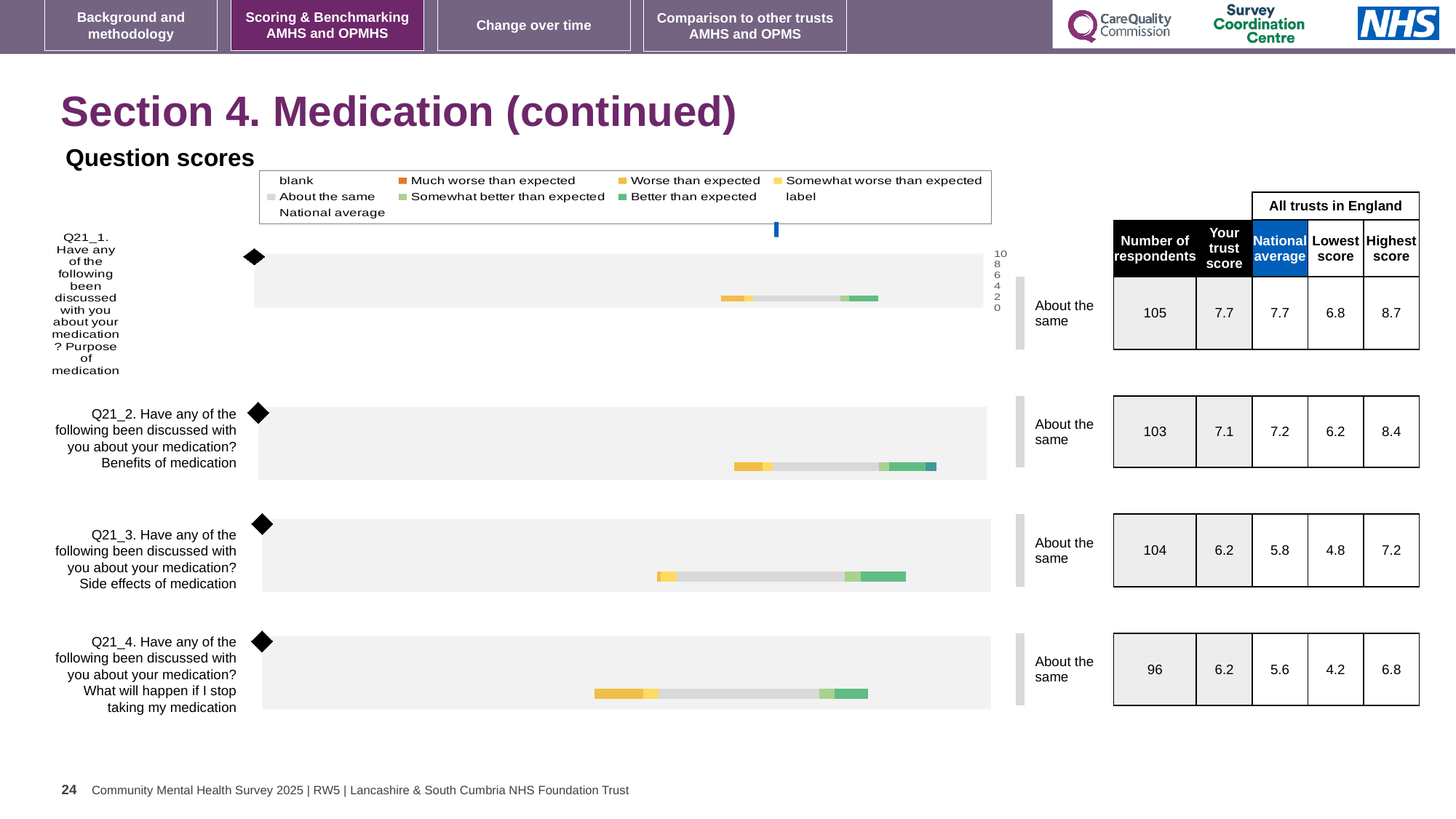
Which question has the lowest number of respondents? Q21_4 (What will happen if I stop taking my medication) What is the 'Your trust score' value for Q21_3 (Side effects of medication)? 6.2 What is the difference between the highest score and the lowest score for Q21_1? 1.9 How many question score charts are shown on the slide? 4 What is the number of respondents for Q21_2 (Benefits of medication)? 103 What is the highest score across all trusts in England for Q21_3? 7.2 What kind of chart is used to show the question scores for Q21_1 to Q21_4? bar chart What benchmark category is shown next to each of the four question charts? About the same What is the national average for Q21_4 (What will happen if I stop taking my medication)? 5.6 Which question has the highest 'Your trust score'? Q21_1 (Purpose of medication) Which legend entry is shown in dark green? Better than expected For Q21_2, which is larger: the trust score or the national average? National average